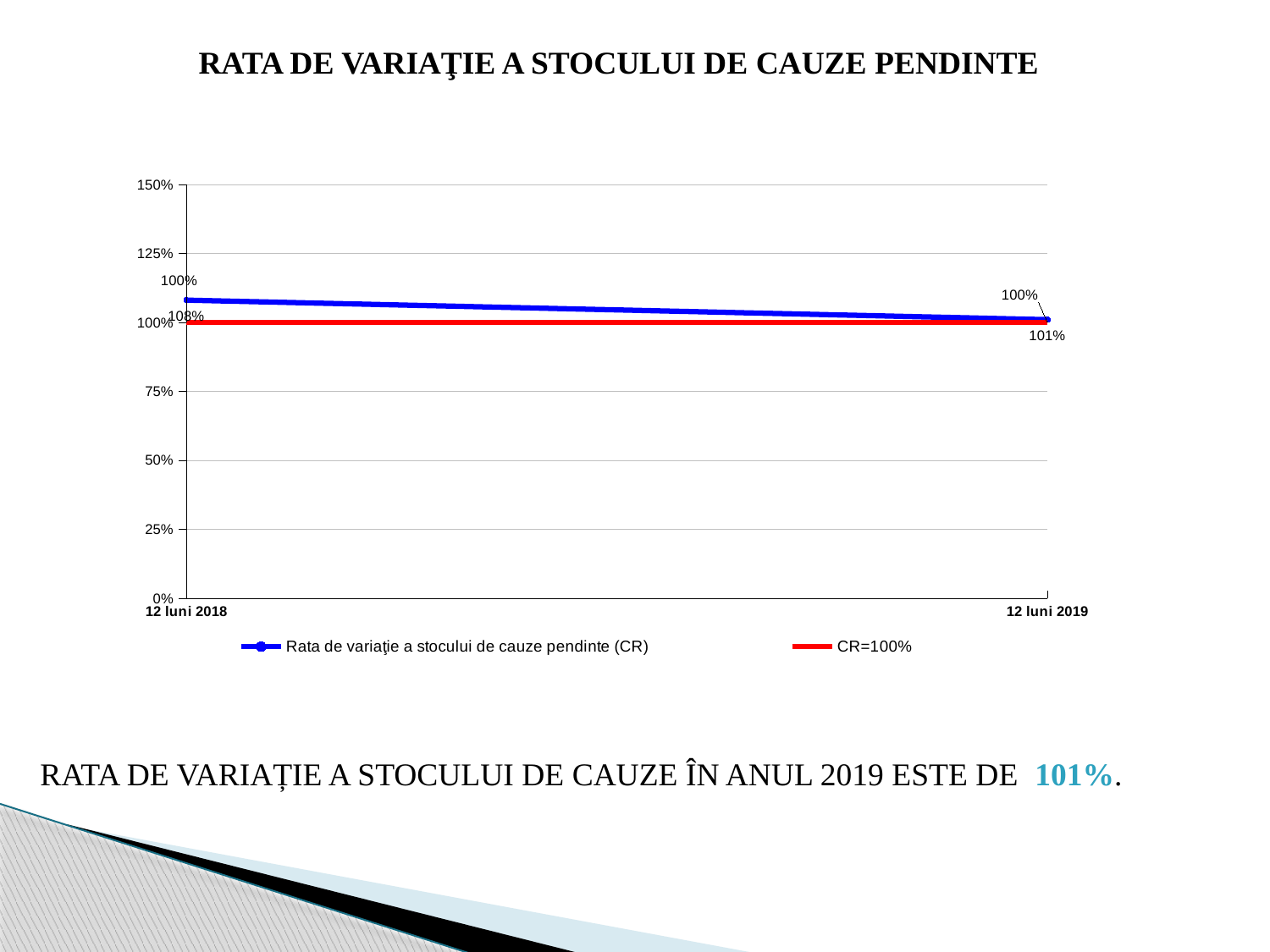
What is the value of the 'CR=100%' series at 12 luni 2019? 100% How many time points are shown on the x axis? 2 Is the CR value at 12 luni 2018 greater or less than 125%? less What is the title of the chart? RATA DE VARIAŢIE A STOCULUI DE CAUZE PENDINTE What kind of chart is shown on the slide? line chart What is the value of 'Rata de variaţie a stocului de cauze pendinte (CR)' at 12 luni 2019? 101% What is the value of 'Rata de variaţie a stocului de cauze pendinte (CR)' at 12 luni 2018? 108% At 12 luni 2019, which is larger: the CR value or the CR=100% reference? the CR value By how many percentage points does the CR value change from 12 luni 2018 (108%) to 12 luni 2019 (101%)? 7 percentage points How many series does the legend list? 2 Does the 'Rata de variaţie a stocului de cauze pendinte (CR)' line rise or fall from 12 luni 2018 to 12 luni 2019? fall In which period is the CR value higher, 12 luni 2018 or 12 luni 2019? 12 luni 2018